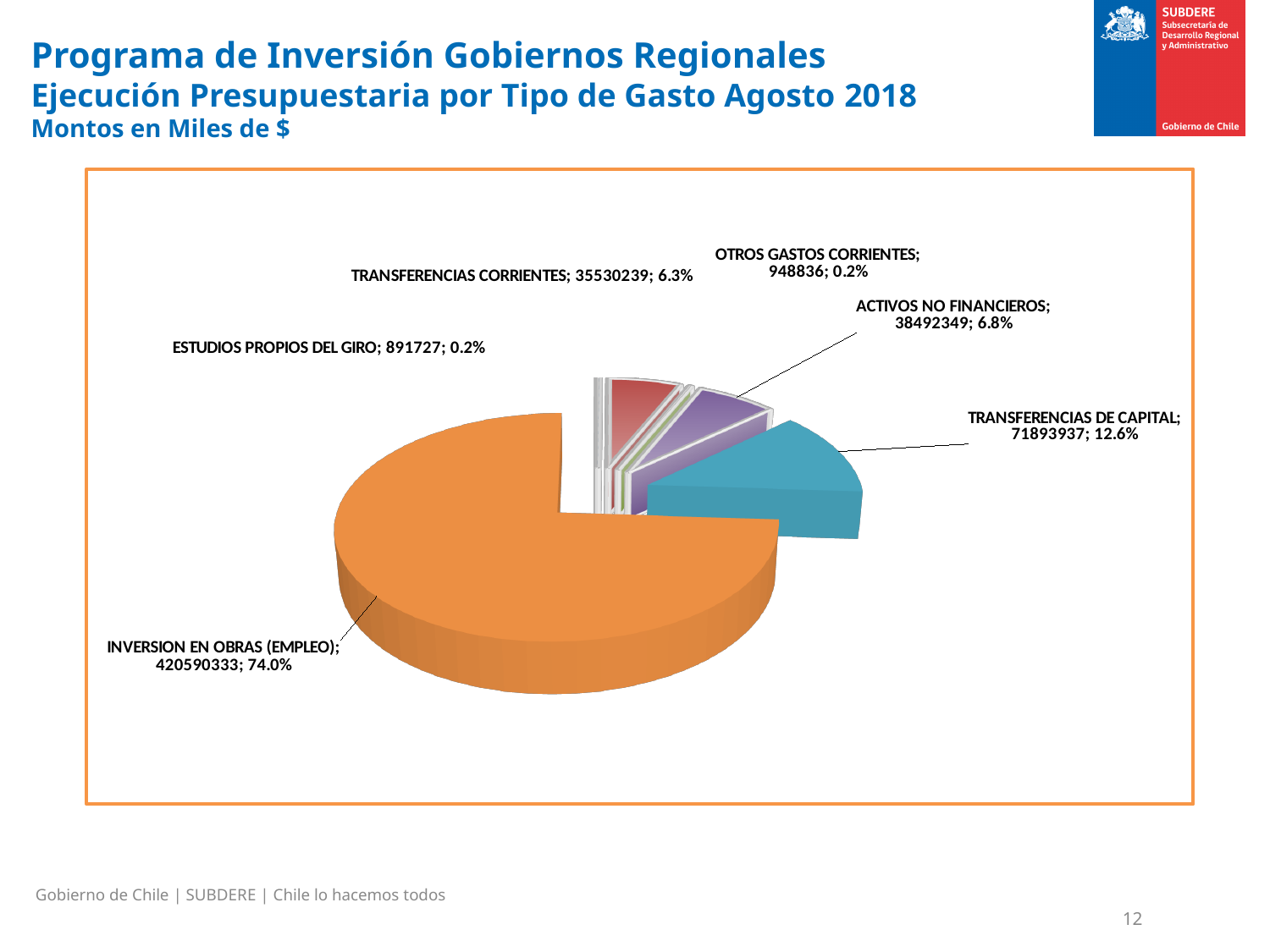
What kind of chart is shown on the slide? Pie chart Which category has the smallest value? ESTUDIOS PROPIOS DEL GIRO What is the value for INVERSION EN OBRAS (EMPLEO)? 420590333 What unit are the amounts in the chart expressed in, according to the slide subtitle? Miles de $ Which is larger, the value for ACTIVOS NO FINANCIEROS or the value for TRANSFERENCIAS CORRIENTES? ACTIVOS NO FINANCIEROS What is the value for OTROS GASTOS CORRIENTES? 948836 What is the difference between the values for TRANSFERENCIAS DE CAPITAL and ACTIVOS NO FINANCIEROS? 33401588 How many slices does the pie chart have? 6 What is the value for ACTIVOS NO FINANCIEROS? 38492349 What percentage share does TRANSFERENCIAS CORRIENTES have? 6.3% Which category has the largest share of the pie? INVERSION EN OBRAS (EMPLEO) What percentage share does TRANSFERENCIAS DE CAPITAL have? 12.6%